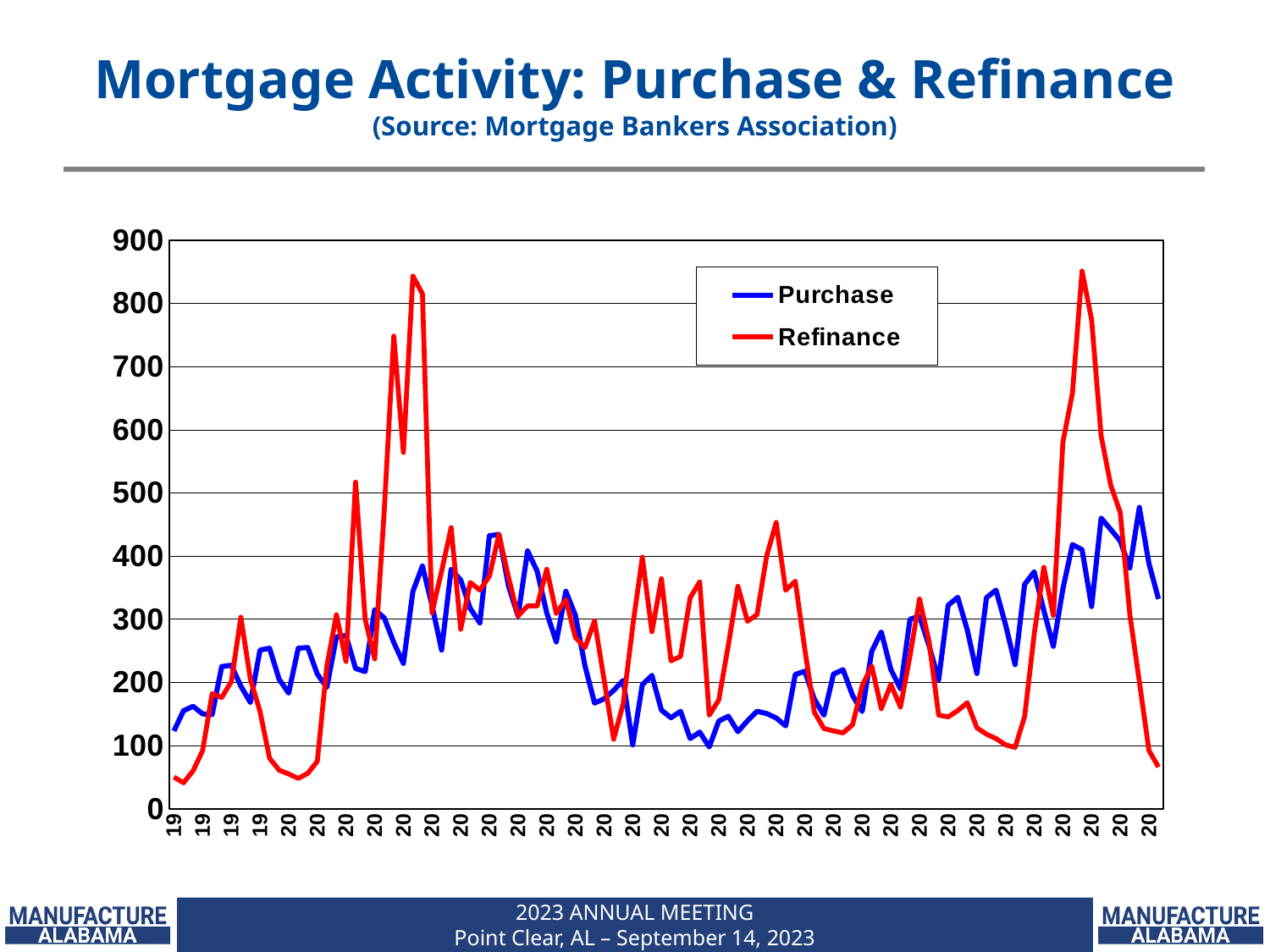
What kind of chart is shown on the slide? Line chart What colour is the Refinance line? Red Is the lowest value of the Refinance line greater or less than 100? less Is the highest value reached by the Refinance line greater or less than 800? greater Is the highest value reached by the Purchase line greater or less than 500? less How many series does the legend list? 2 Which series drops to the lower minimum value, Purchase or Refinance? Refinance What is the highest value shown on the y axis? 900 What are the two series named in the legend? Purchase and Refinance Which series reaches the higher peak value, Purchase or Refinance? Refinance